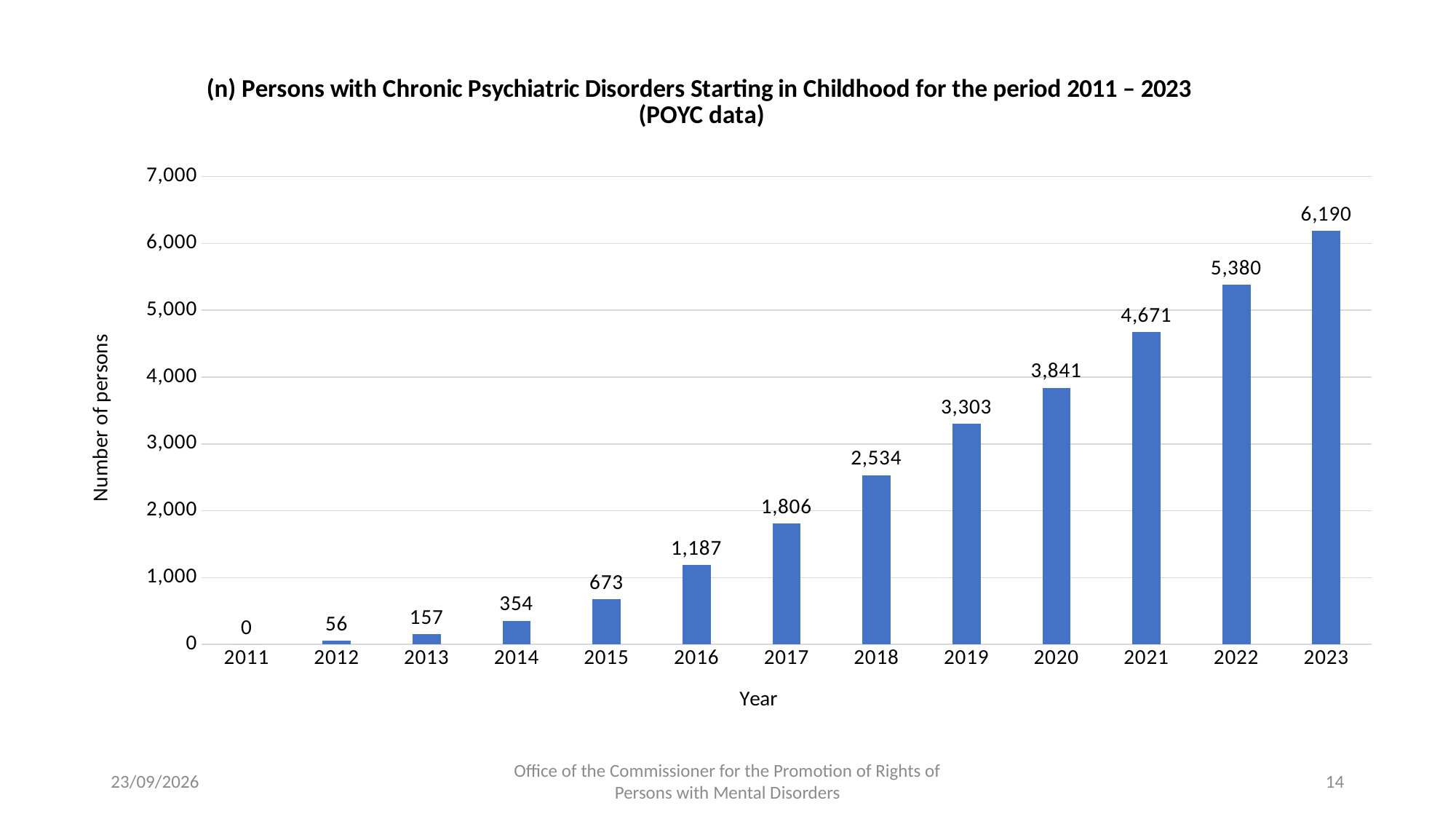
Is the value for 2020 greater or less than 4,000? less How many years are shown on the x axis? 13 What kind of chart is this? bar chart Do the values rise or fall from 2011 to 2023? rise What is the number of persons for 2023? 6,190 Which is larger, the value for 2017 or the value for 2015? 2017 What is the number of persons for 2016? 1,187 Which year has the lowest number of persons? 2011 What is the difference between the values for 2019 and 2018? 769 Which year has the highest number of persons? 2023 What is the difference between the values for 2023 and 2022? 810 What is the number of persons for 2012? 56